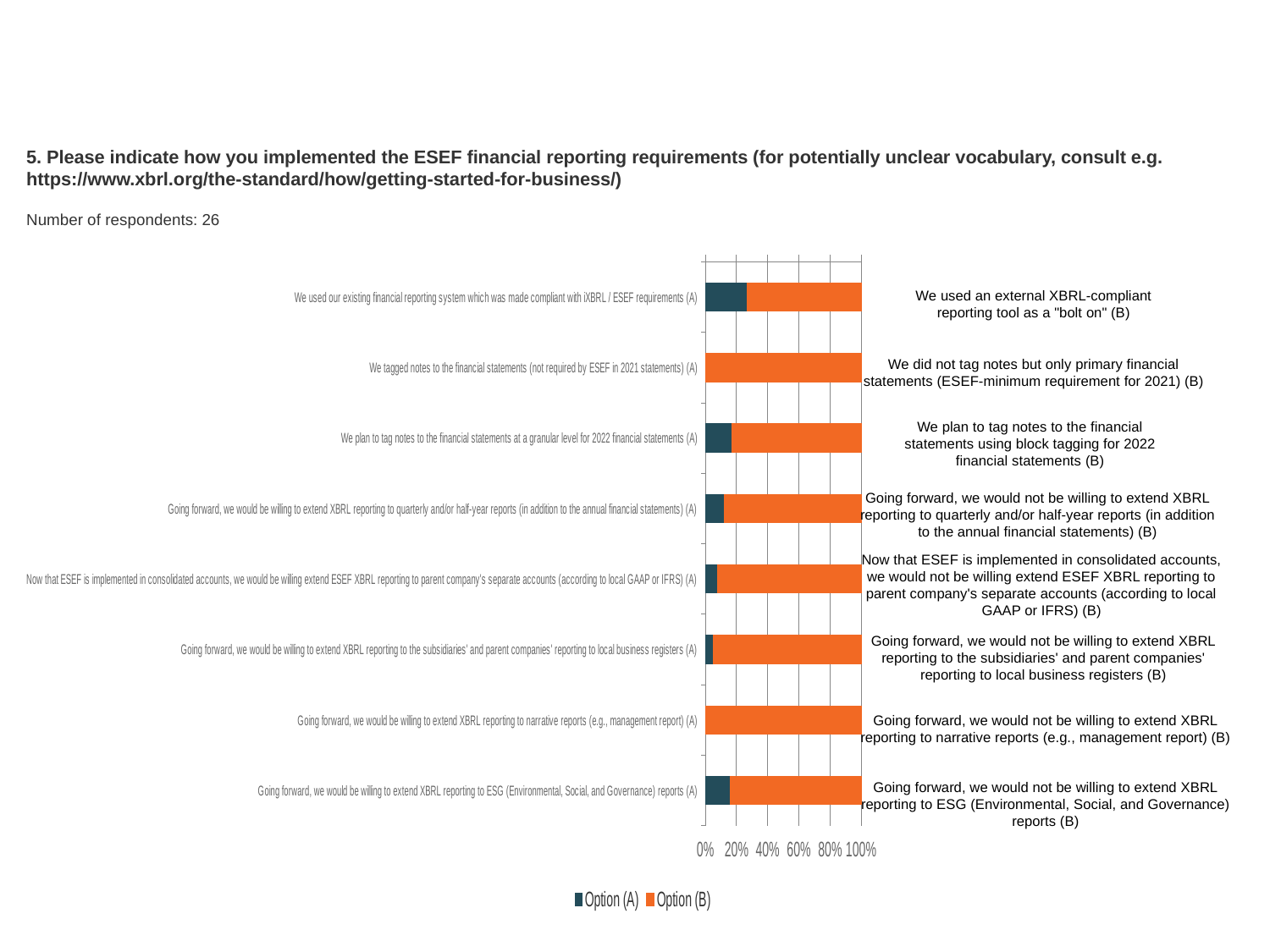
What are the two series named in the legend? Option (A) and Option (B) How many series does the legend list? 2 Which category has the largest Option (A) share? We used our existing financial reporting system which was made compliant with iXBRL / ESEF requirements (A) How many respondents does the slide say answered this question? 26 Is the Option (A) value for 'Going forward, we would be willing to extend XBRL reporting to quarterly and/or half-year reports (in addition to the annual financial statements) (A)' greater or less than 20%? less Is the Option (B) value for 'We used our existing financial reporting system which was made compliant with iXBRL / ESEF requirements (A)' greater or less than 80%? less Is the Option (A) value for 'We used our existing financial reporting system which was made compliant with iXBRL / ESEF requirements (A)' greater or less than 20%? greater Which has the larger Option (B) share: 'We tagged notes to the financial statements (not required by ESEF in 2021 statements) (A)' or 'We used our existing financial reporting system which was made compliant with iXBRL / ESEF requirements (A)'? We tagged notes to the financial statements (not required by ESEF in 2021 statements) (A) What kind of chart is shown on the slide? bar chart Which has the larger Option (A) share: 'We used our existing financial reporting system which was made compliant with iXBRL / ESEF requirements (A)' or 'We plan to tag notes to the financial statements at a granular level for 2022 financial statements (A)'? We used our existing financial reporting system which was made compliant with iXBRL / ESEF requirements (A) How many categories (bars) are plotted in the chart? 8